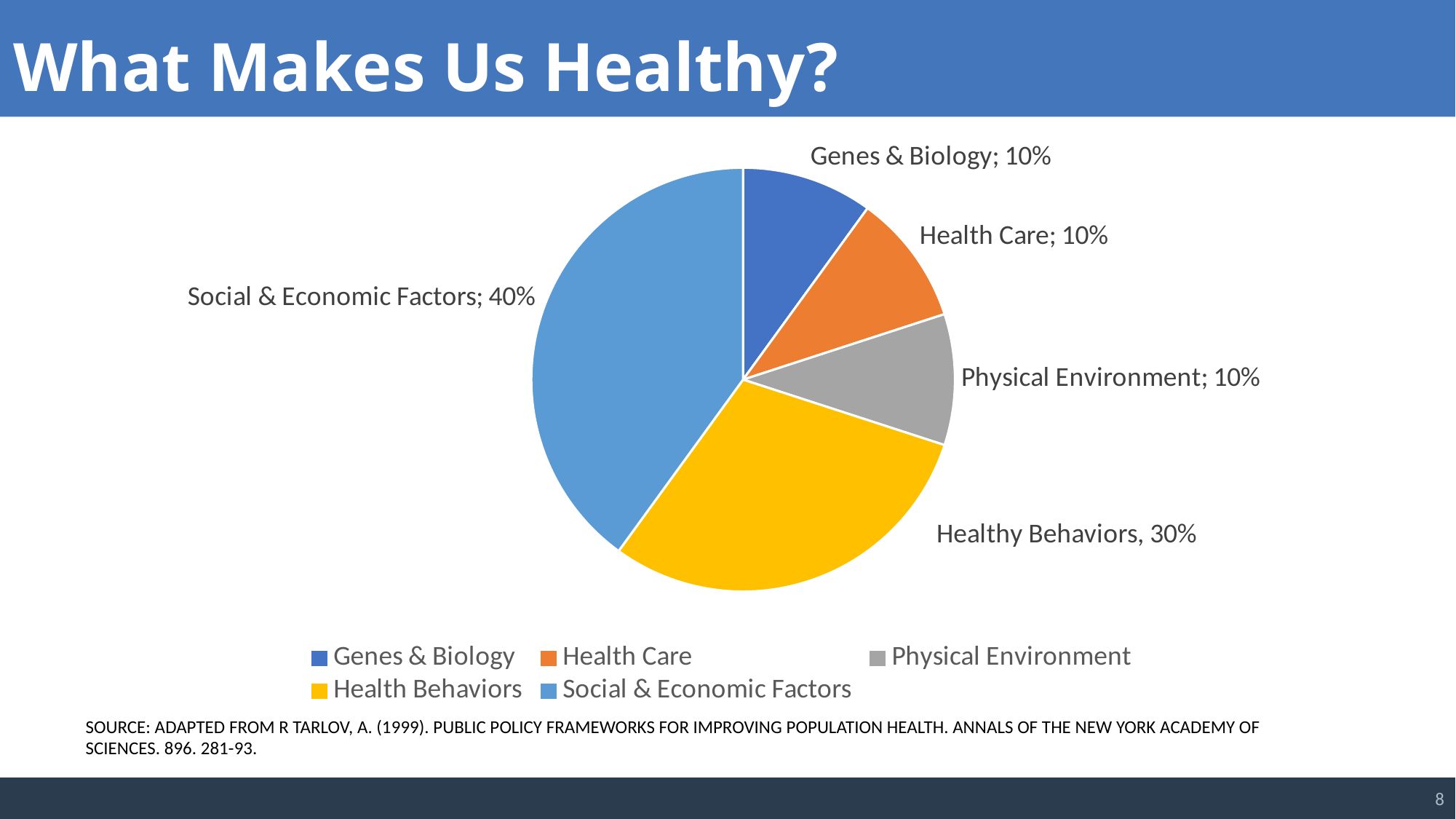
What colour is the Healthy Behaviors slice? yellow Which category has the largest slice of the pie? Social & Economic Factors What share of the pie is Social & Economic Factors? 40% How many entries does the legend list? 5 Which is larger, the Healthy Behaviors slice or the Genes & Biology slice? Healthy Behaviors What is the value shown for Healthy Behaviors? 30% What is the value shown for Physical Environment? 10% What is the difference between the Social & Economic Factors share and the Healthy Behaviors share? 10% How many slices does the pie chart have? 5 What is the combined share of Genes & Biology, Health Care and Physical Environment? 30% What is the value shown for Health Care? 10% What kind of chart is shown on the slide? pie chart